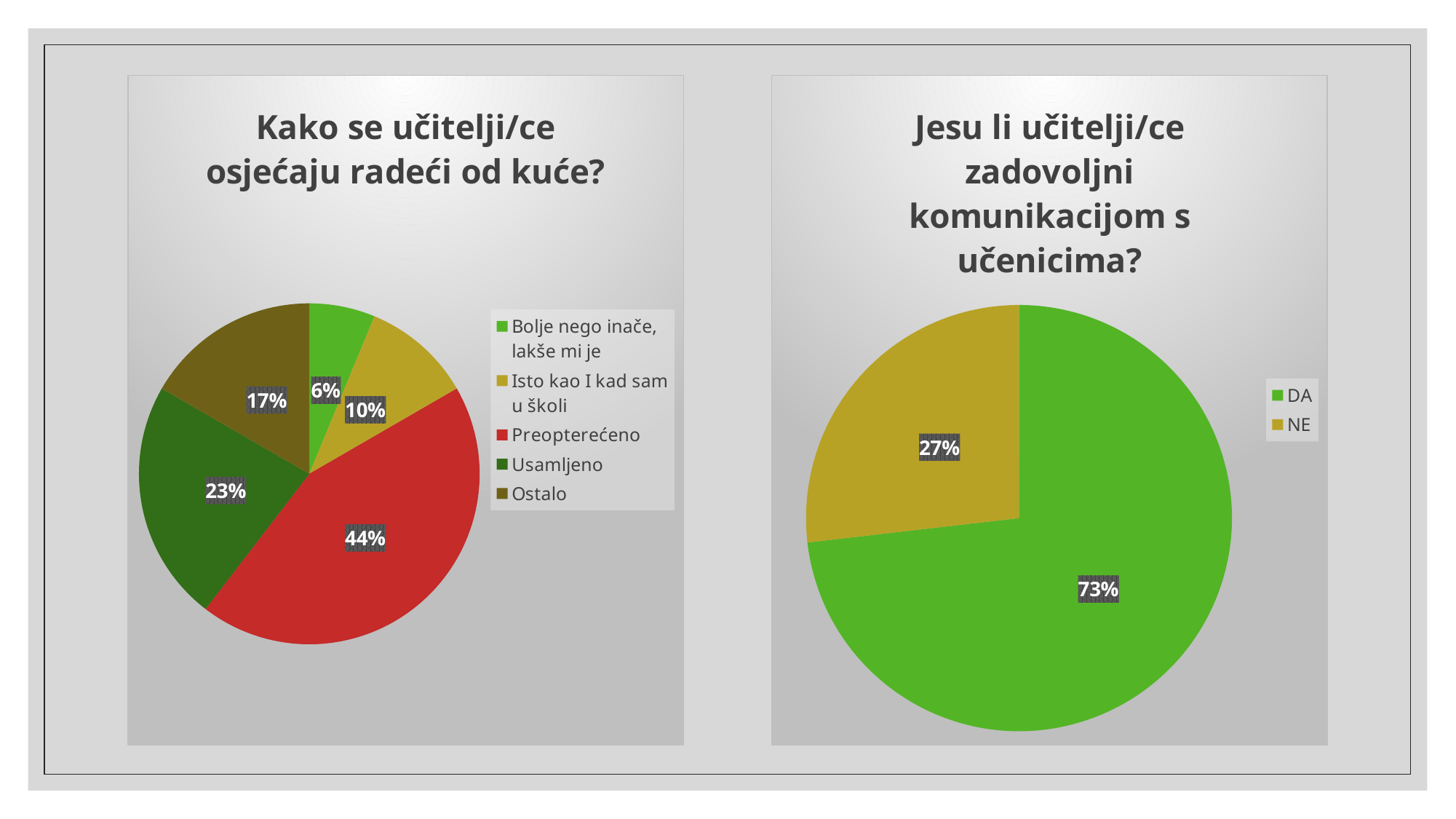
In the left chart 'Kako se učitelji/ce osjećaju radeći od kuće?', what share is labelled for 'Preopterećeno'? 44% In the left chart 'Kako se učitelji/ce osjećaju radeći od kuće?', what is the difference in percentage points between 'Preopterećeno' and 'Ostalo'? 27 In the left chart 'Kako se učitelji/ce osjećaju radeći od kuće?', which is larger: 'Usamljeno' or 'Isto kao I kad sam u školi'? Usamljeno In the right chart 'Jesu li učitelji/ce zadovoljni komunikacijom s učenicima?', what is the difference in percentage points between 'DA' and 'NE'? 46 In the right chart 'Jesu li učitelji/ce zadovoljni komunikacijom s učenicima?', what share is labelled for 'NE'? 27% In the left chart 'Kako se učitelji/ce osjećaju radeći od kuće?', which category has the largest slice? Preopterećeno How many categories does the legend of the left chart 'Kako se učitelji/ce osjećaju radeći od kuće?' list? 5 In the left chart 'Kako se učitelji/ce osjećaju radeći od kuće?', which category has the smallest slice? Bolje nego inače, lakše mi je In the right chart 'Jesu li učitelji/ce zadovoljni komunikacijom s učenicima?', what colour is the 'DA' slice? Green In the left chart 'Kako se učitelji/ce osjećaju radeći od kuće?', what share is labelled for 'Bolje nego inače, lakše mi je'? 6% In the left chart 'Kako se učitelji/ce osjećaju radeći od kuće?', what share is labelled for 'Usamljeno'? 23% What kind of chart is the right chart 'Jesu li učitelji/ce zadovoljni komunikacijom s učenicima?'? Pie chart